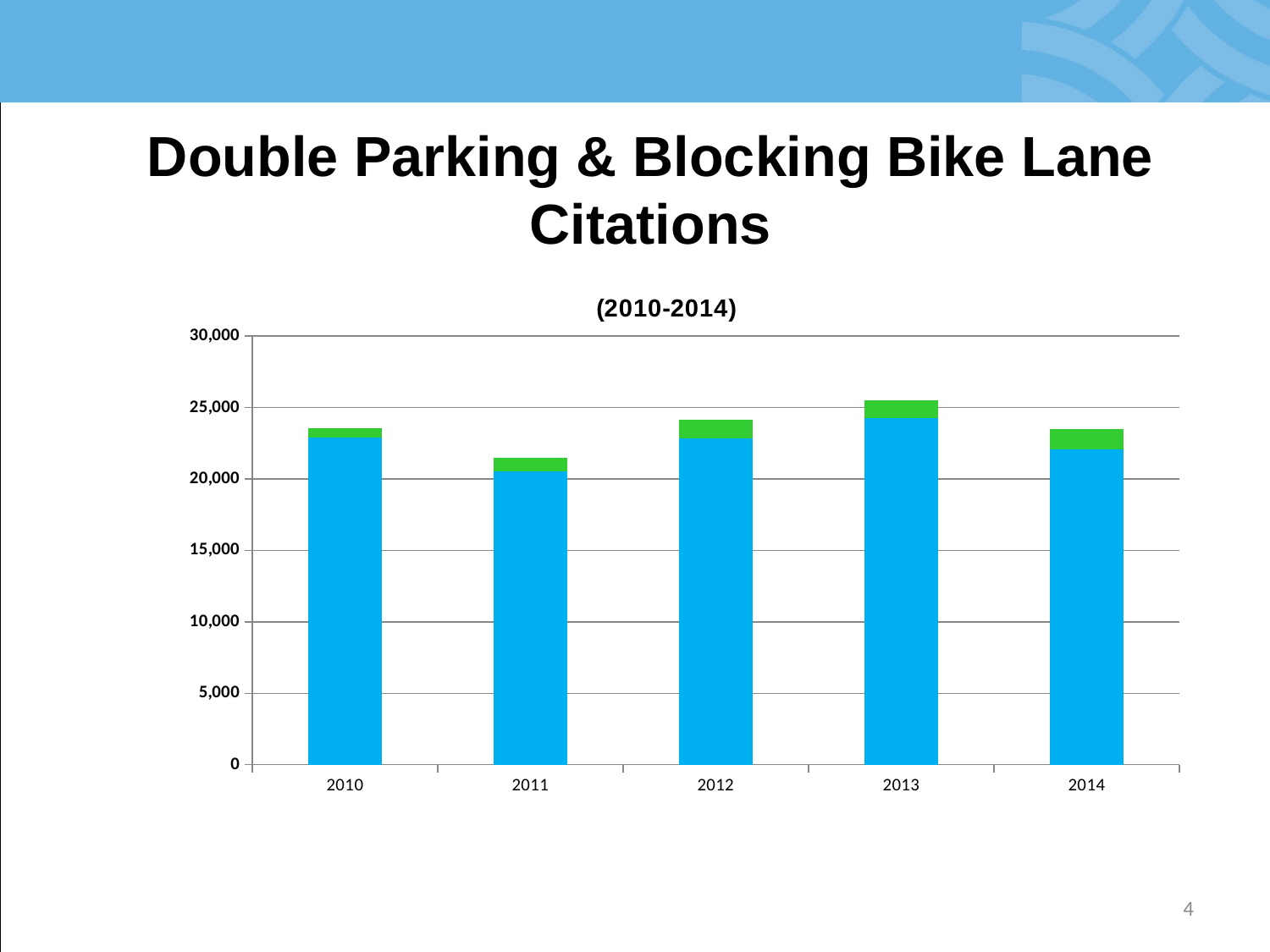
Which year has a taller bar, 2013 or 2011? 2013 What period is given in the subtitle above the chart? (2010-2014) Is the total bar height for 2010 greater or less than 20,000? greater Which year has the shortest bar in the chart? 2011 Is the total bar height for 2013 greater or less than 25,000? greater Does the bar height rise or fall from 2010 to 2011? fall Is the blue segment for 2011 greater or less than 25,000? less How many years are shown on the x axis of the chart? 5 Which year has a taller bar, 2012 or 2011? 2012 Which year has the tallest bar in the chart? 2013 What kind of chart is shown on the slide? Stacked bar chart